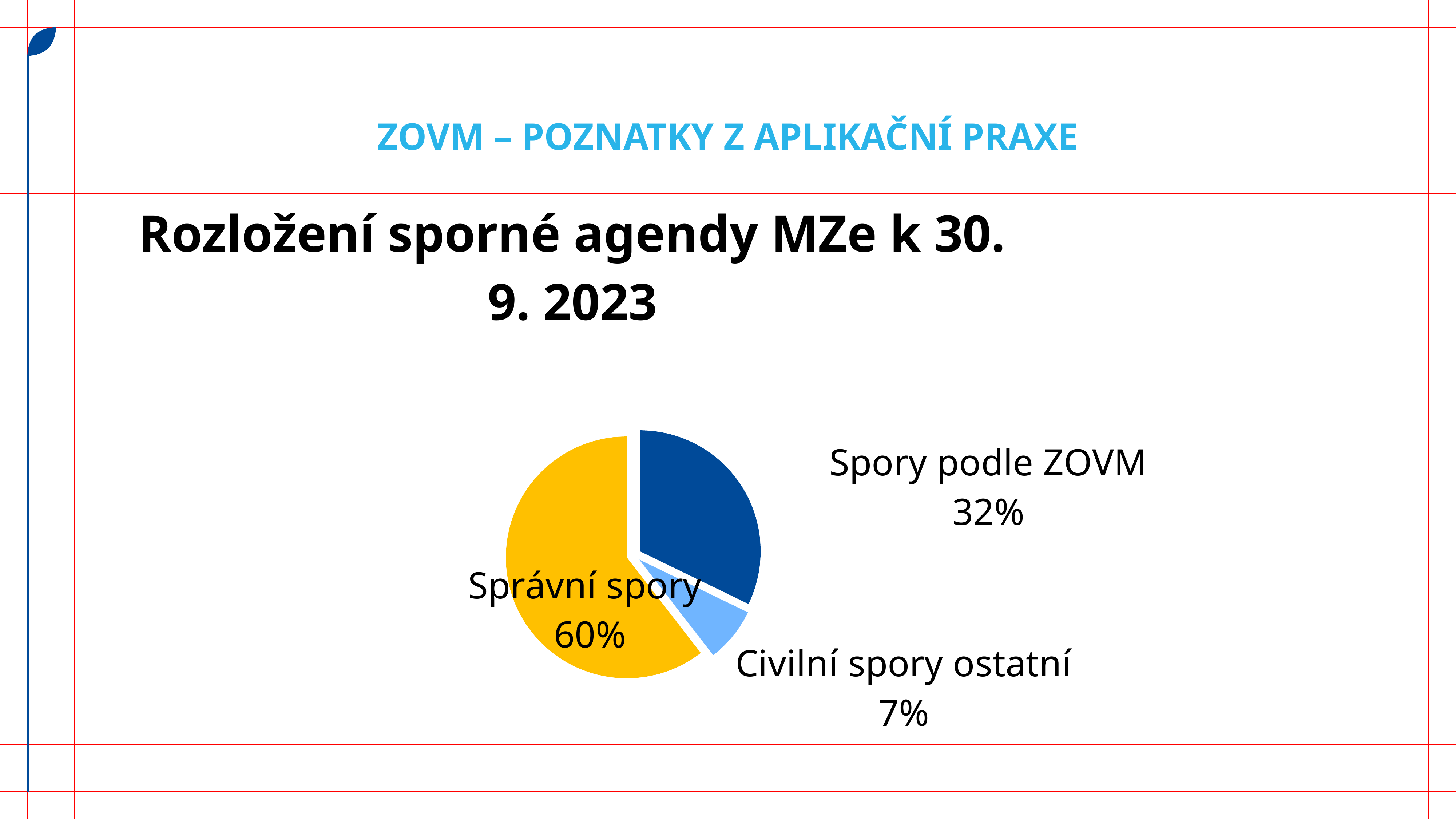
What is the title of the chart? Rozložení sporné agendy MZe k 30. 9. 2023 How many slices does the pie chart have? 3 What share of the pie does Správní spory have? 60% Which category has the largest slice of the pie? Správní spory What share of the pie does Spory podle ZOVM have? 32% What share of the pie does Civilní spory ostatní have? 7% What is the difference in percentage points between Spory podle ZOVM and Civilní spory ostatní? 25 What kind of chart is shown on the slide? Pie chart What is the difference in percentage points between Správní spory and Spory podle ZOVM? 28 Which category has the smallest slice of the pie? Civilní spory ostatní What colour is the Správní spory slice? Yellow Which is larger, Spory podle ZOVM or Civilní spory ostatní? Spory podle ZOVM